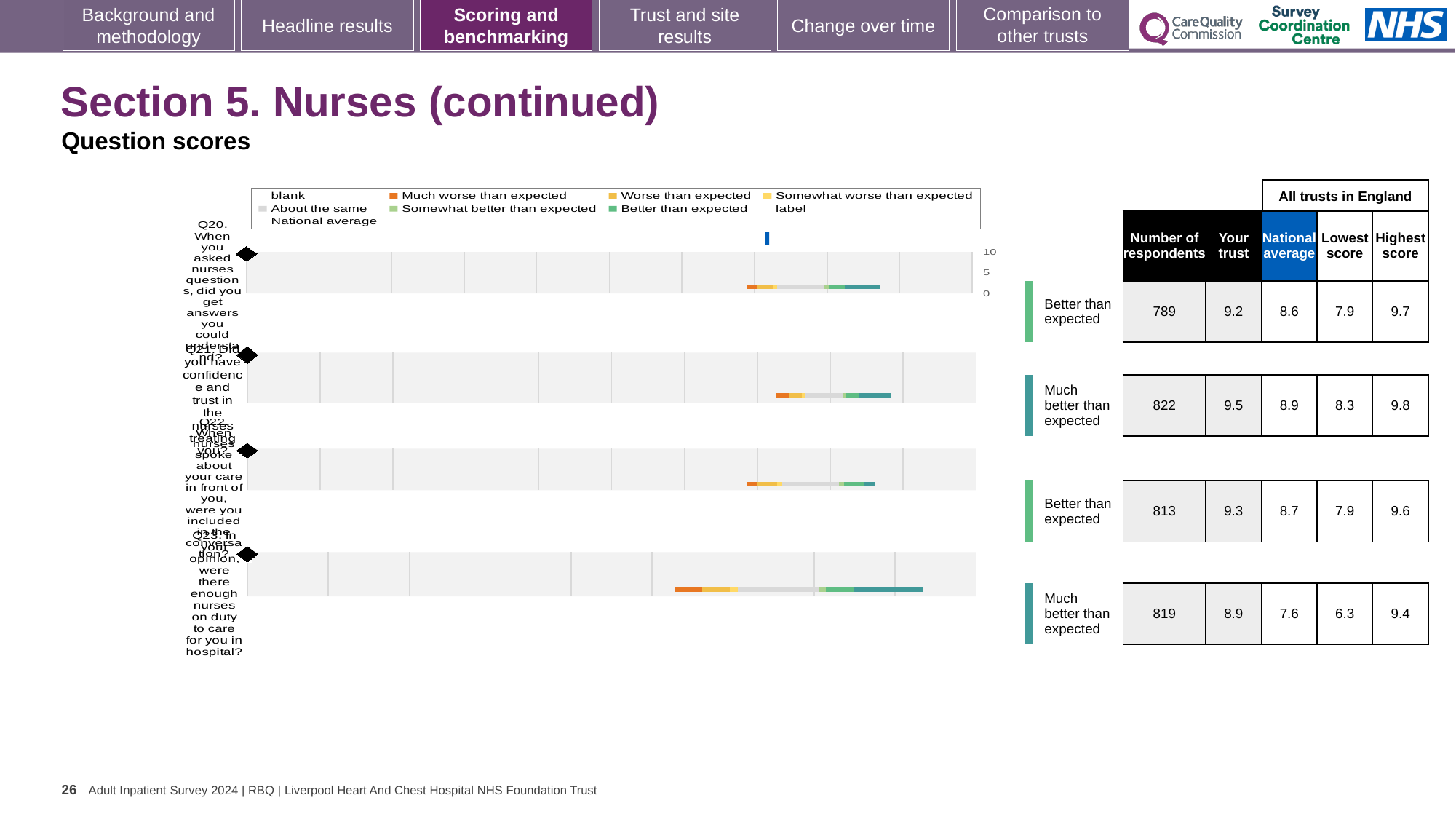
How many entries does the chart legend list? 9 Which question has the highest 'Your trust' score? Q21 What is the difference between the 'Your trust' score and the national average for Q23? 1.3 What is the 'Your trust' score for Q20 (When you asked nurses questions, did you get answers you could understand)? 9.2 What is the national average score for Q21 (Did you have confidence and trust in the nurses treating you)? 8.9 How many questions (rows) are plotted in the chart? 4 What is the lowest score among all trusts in England for Q23 (In your opinion, were there enough nurses on duty to care for you in hospital)? 6.3 Is the 'Your trust' score for Q22 higher or lower than the national average for Q22? higher What kind of chart is shown on the slide? bar chart Which question has the lowest national average score? Q23 What benchmark category is shown for Q21? Much better than expected How many respondents answered Q22 (When nurses spoke about your care in front of you, were you included in the conversation)? 813